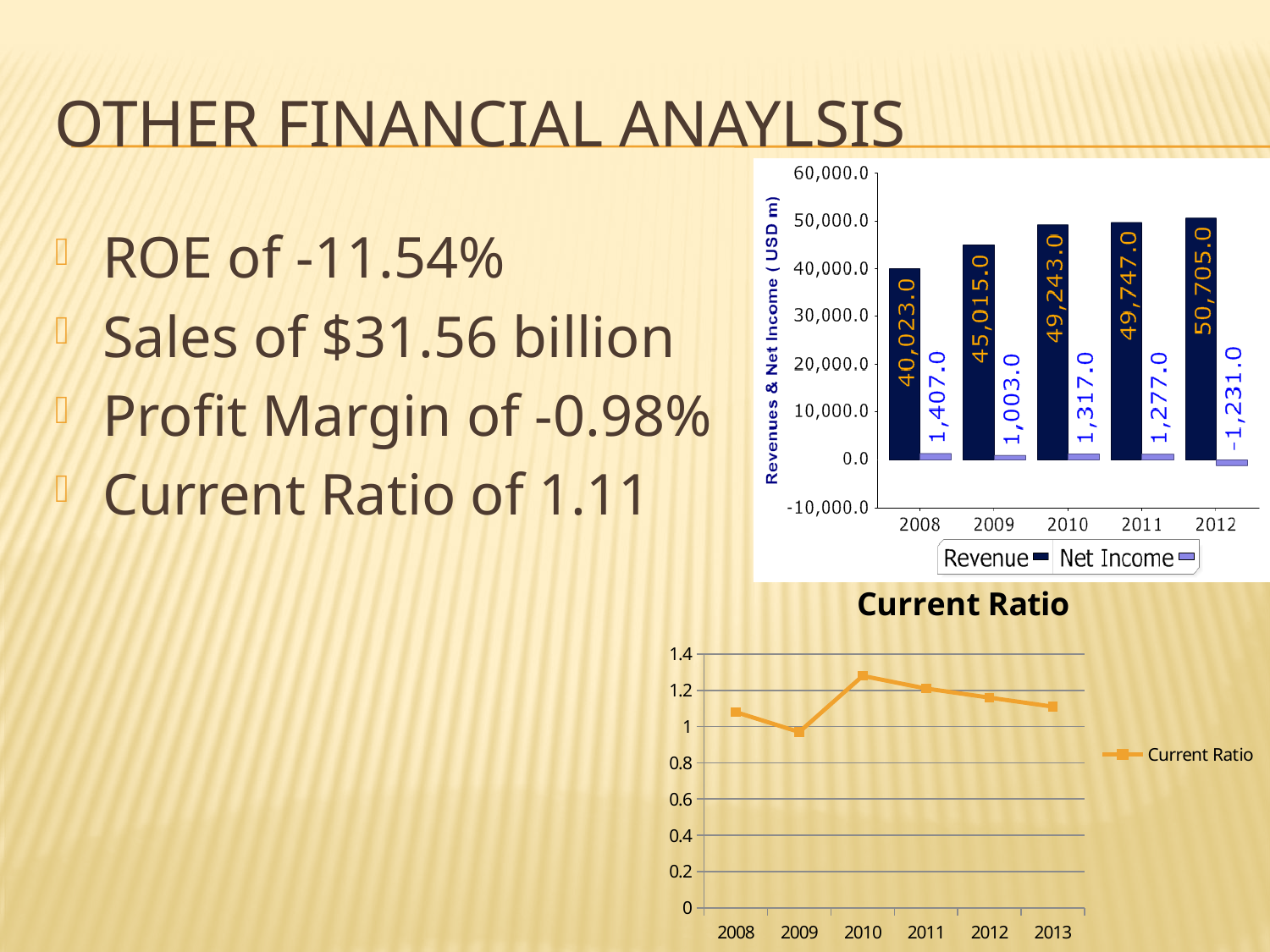
In the top-right bar chart of Revenues & Net Income, is Net Income higher in 2008 or in 2009? 2008 In the top-right bar chart of Revenues & Net Income, what is the Net Income value for 2012? -1,231.0 In the Current Ratio chart, which year has the highest current ratio? 2010 In the Current Ratio chart, does the current ratio rise or fall from 2010 to 2013? fall How many series does the legend of the top-right bar chart list? 2 What kind of chart is the Current Ratio chart? line chart In the top-right bar chart of Revenues & Net Income, what is the difference between Revenue in 2009 and Revenue in 2008? 4,992.0 In the Current Ratio chart, is the value for 2010 greater or less than 1.2? greater In the top-right bar chart of Revenues & Net Income, which year has the lowest Net Income? 2012 In the top-right bar chart of Revenues & Net Income, which year has the highest Revenue? 2012 How many years are shown on the x axis of the top-right bar chart? 5 In the top-right bar chart of Revenues & Net Income, what is the Revenue value for 2010? 49,243.0